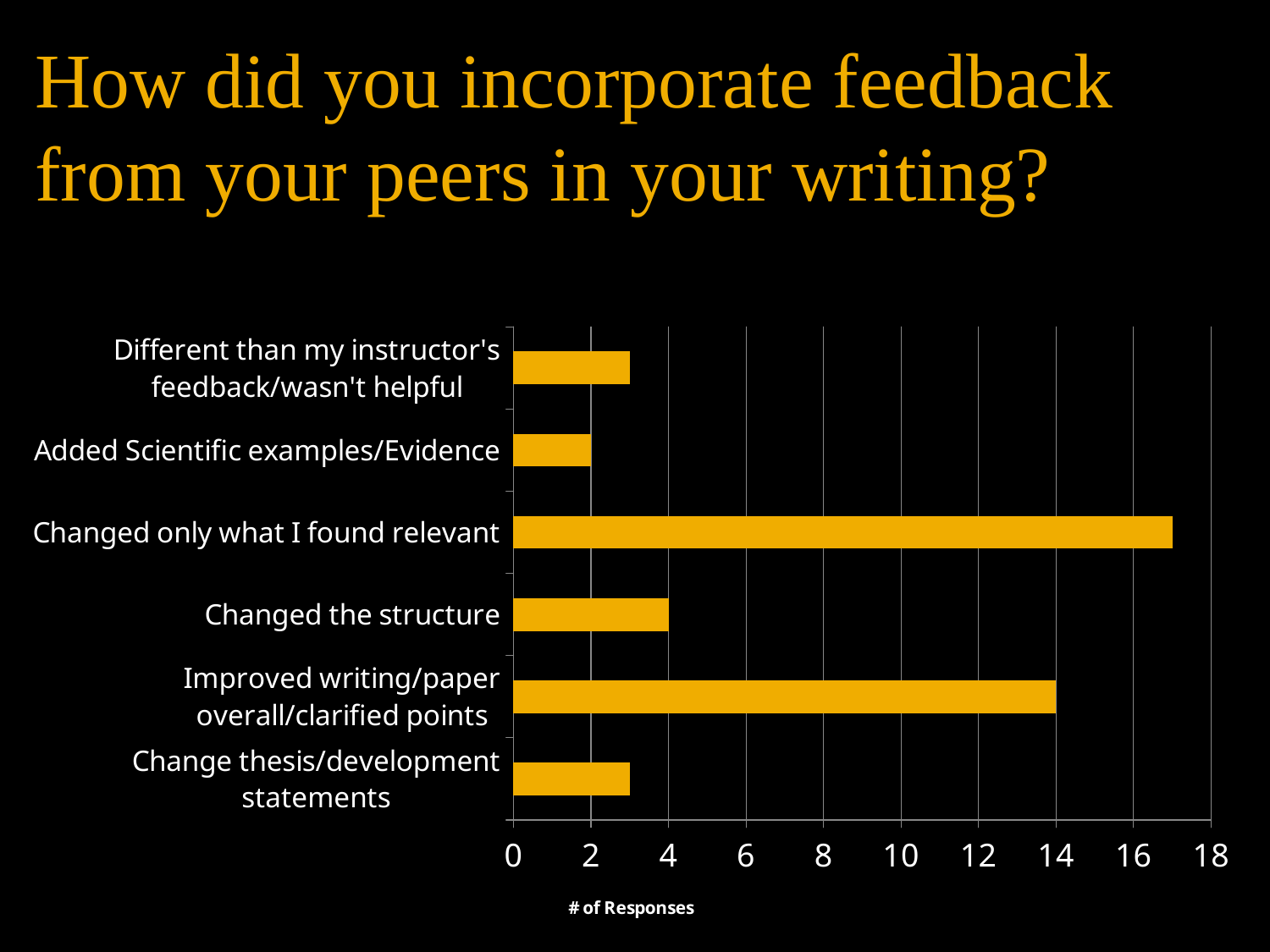
How many responses are there for "Improved writing/paper overall/clarified points"? 14 What is the label on the horizontal axis of the chart? # of Responses Which category has the lowest number of responses? Added Scientific examples/Evidence What is the difference in responses between "Improved writing/paper overall/clarified points" and "Changed the structure"? 10 Is the value for "Changed only what I found relevant" greater or less than 16? greater What kind of chart is shown on the slide? bar chart How many categories are shown in the chart? 6 How many responses are there for "Added Scientific examples/Evidence"? 2 Which category has the highest number of responses? Changed only what I found relevant Which has more responses, "Changed the structure" or "Added Scientific examples/Evidence"? Changed the structure Is the value for "Change thesis/development statements" greater or less than 10? less How many responses are there for "Changed the structure"? 4